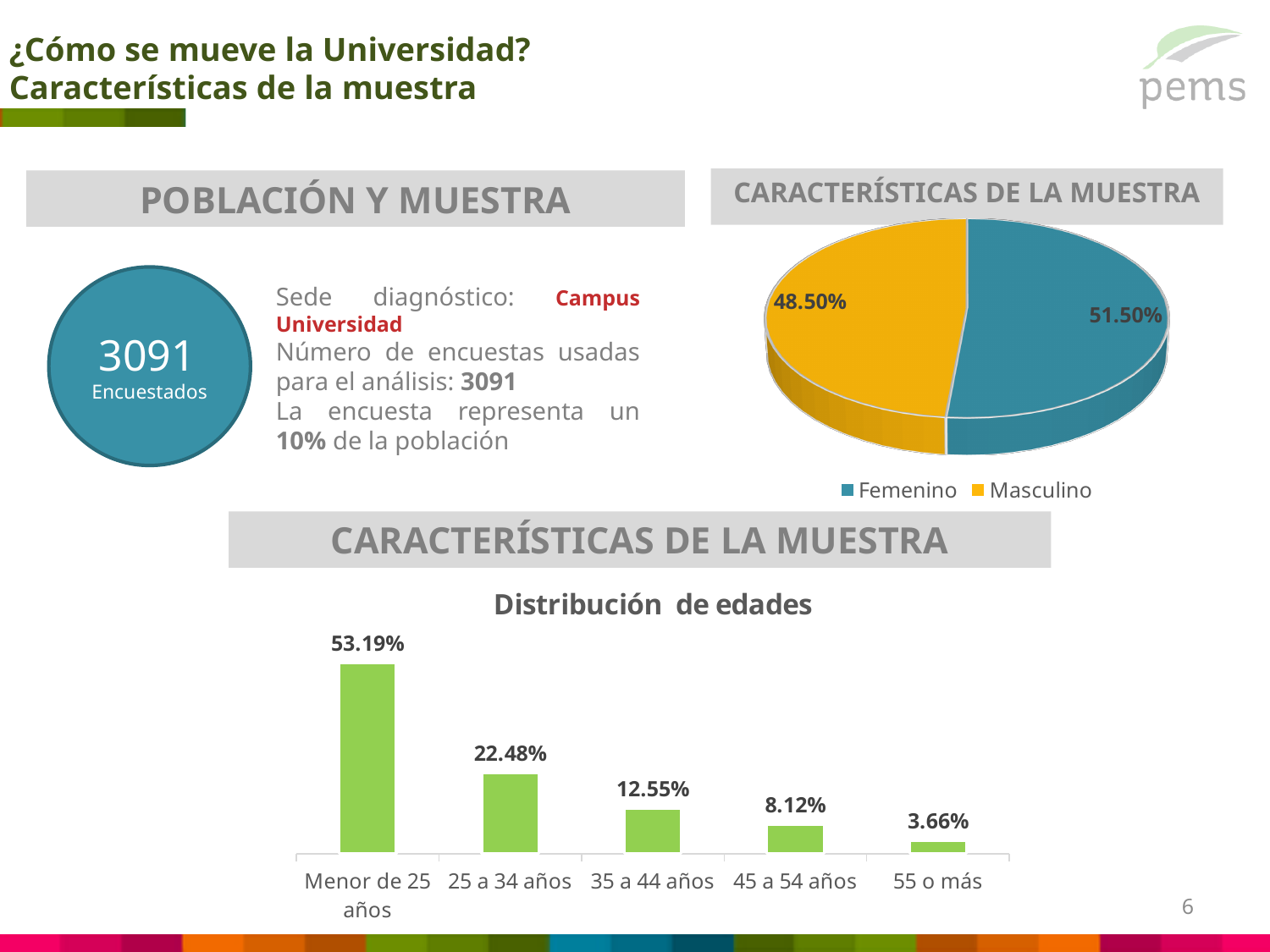
In the 'Distribución de edades' chart, what is the value for '45 a 54 años'? 8.12% In the 'Distribución de edades' chart, what is the value for 'Menor de 25 años'? 53.19% In the pie chart, which slice is larger, Femenino or Masculino? Femenino In the 'Distribución de edades' chart, which age group has the highest value? Menor de 25 años How many series does the pie chart legend list? 2 In the pie chart, what is the difference between the Femenino and Masculino shares? 3.00% In the 'Distribución de edades' chart, what is the difference between '25 a 34 años' and '35 a 44 años'? 9.93% How many age categories are shown in the 'Distribución de edades' chart? 5 In the pie chart, what colour is the Masculino slice? Yellow/orange In the pie chart, what share is Masculino? 48.50% In the pie chart, what share is Femenino? 51.50% In the 'Distribución de edades' chart, which age group has the lowest value? 55 o más